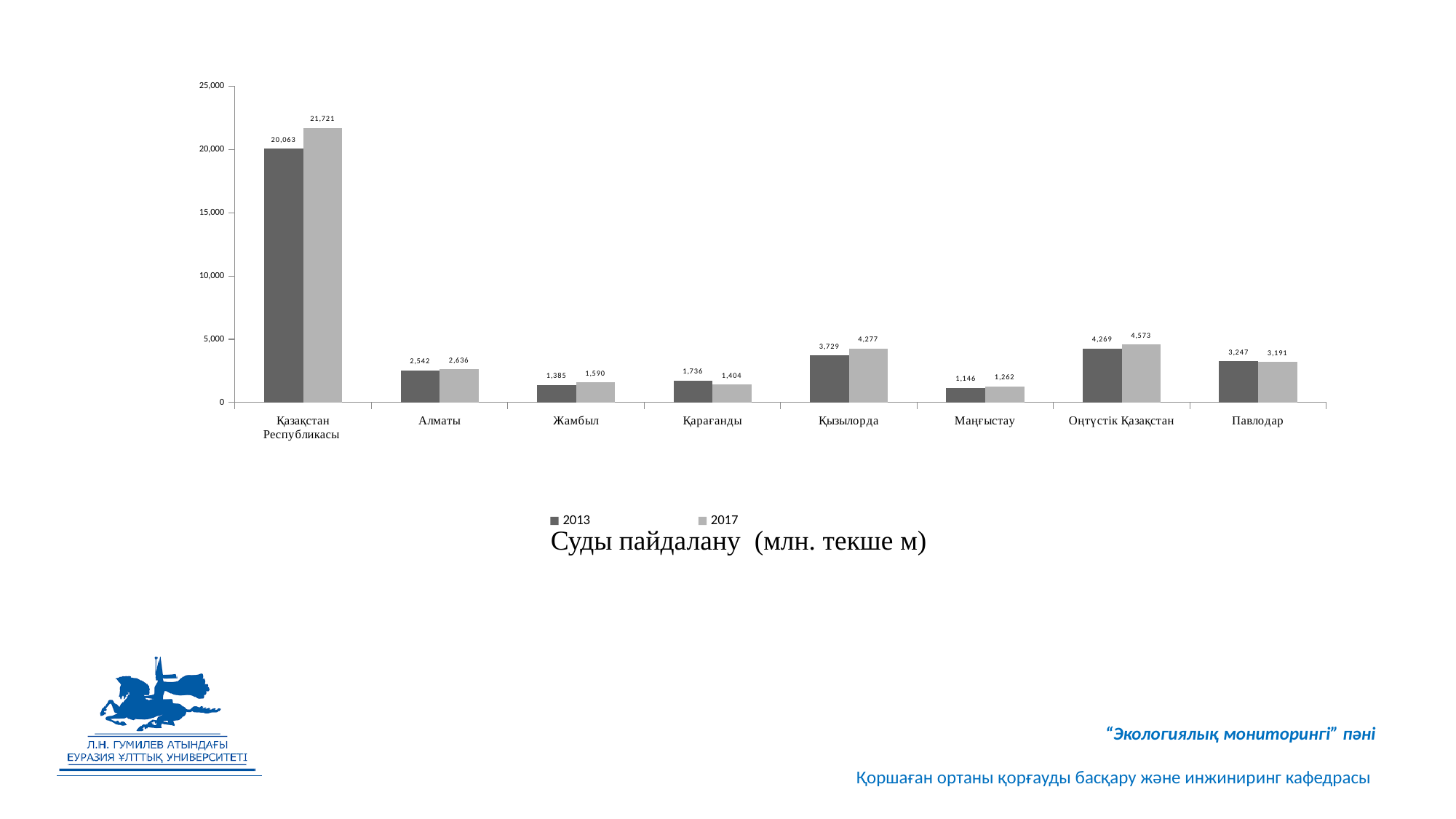
Which category has the lowest 2013 value? Маңғыстау What is the 2013 value for Павлодар? 3,247 Which is larger for Оңтүстік Қазақстан, the 2013 value or the 2017 value? 2017 What is the difference between the 2017 and 2013 values for Қазақстан Республикасы? 1,658 What kind of chart is shown on the slide? bar chart Is the 2017 value for Алматы greater or less than 5,000? less How many series does the legend list? 2 Which category has the highest 2017 value? Қазақстан Республикасы How many categories are shown on the x axis? 8 What is the 2017 value for Қызылорда? 4,277 What is the difference between the 2013 and 2017 values for Қарағанды? 332 What is the 2013 value for Жамбыл? 1,385